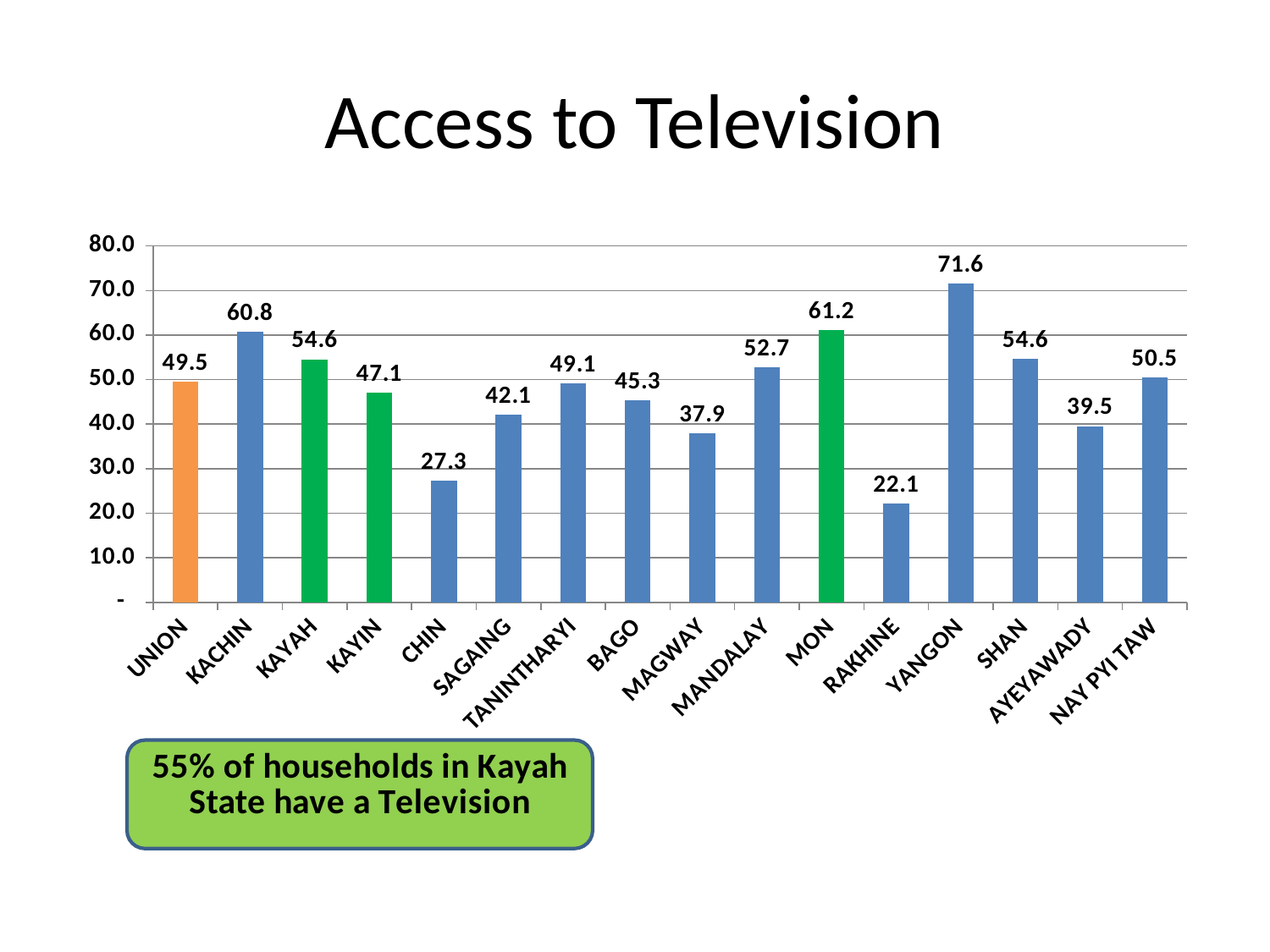
What is the title of the chart? Access to Television Is the value for Chin greater or less than 30.0? less Which category has the lowest value? Rakhine Which category has the highest value? Yangon What is the value for Kayah? 54.6 What is the difference between the values for Yangon and Rakhine? 49.5 What kind of chart is shown? Bar chart Which bar is coloured orange? Union What is the value for Rakhine? 22.1 Which is larger, the value for Mon or the value for Kachin? Mon How many categories are shown on the x axis? 16 What is the value for Union? 49.5